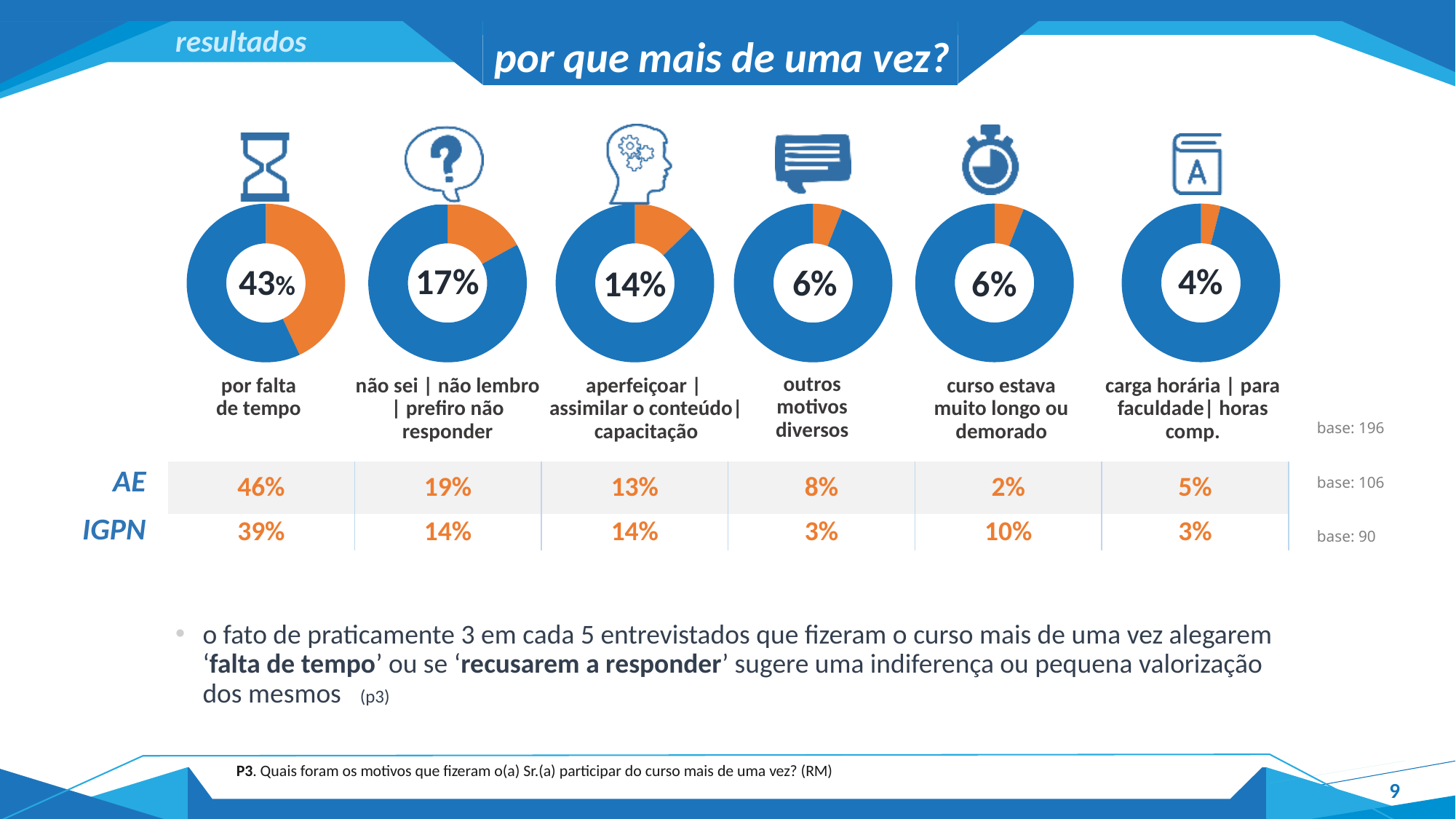
What share of the 'outros motivos diversos' donut does the orange slice represent? 6% What is the title of the slide containing the donut charts? por que mais de uma vez? What value is shown in the donut chart labelled 'por falta de tempo'? 43% Which is larger: the value for 'aperfeiçoar | assimilar o conteúdo | capacitação' or the value for 'outros motivos diversos'? aperfeiçoar | assimilar o conteúdo | capacitação What kind of chart is used to display each percentage on the slide? Donut (pie) chart What value is shown in the donut chart labelled 'aperfeiçoar | assimilar o conteúdo | capacitação'? 14% Which category has the lowest value among the donut charts? carga horária | para faculdade | horas comp. Which category has the highest value among the donut charts? por falta de tempo What value is shown in the donut chart labelled 'carga horária | para faculdade | horas comp.'? 4% What value is shown in the donut chart labelled 'não sei | não lembro | prefiro não responder'? 17% What is the difference in percentage points between the 'por falta de tempo' donut and the 'não sei | não lembro | prefiro não responder' donut? 26 How many donut charts are shown on the slide? 6